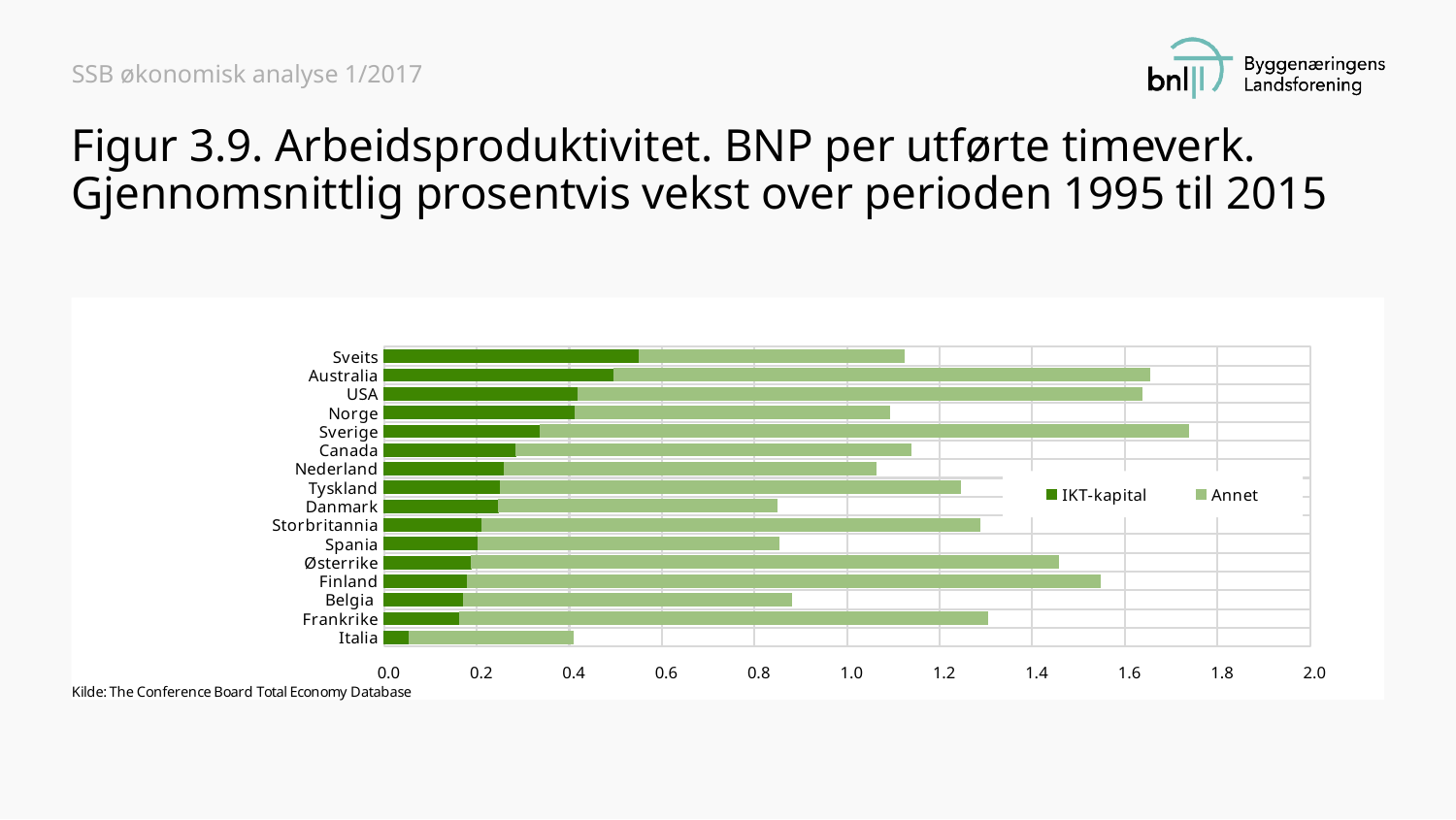
How many series does the chart's legend list? 2 How many countries are listed on the vertical axis of the chart? 16 What are the two series named in the legend? IKT-kapital and Annet Is the total bar for Italia greater or less than 0.6? less Which has the larger IKT-kapital segment, Norge or Italia? Norge Is the total bar for Sverige greater or less than 1.6? greater Which country has the largest IKT-kapital segment? Sveits Is the IKT-kapital value for Sveits greater or less than 0.4? greater What kind of chart is shown on the slide? Bar chart (stacked horizontal bars) Which has the longer total bar, Finland or Belgia? Finland Which country has the shortest total bar? Italia